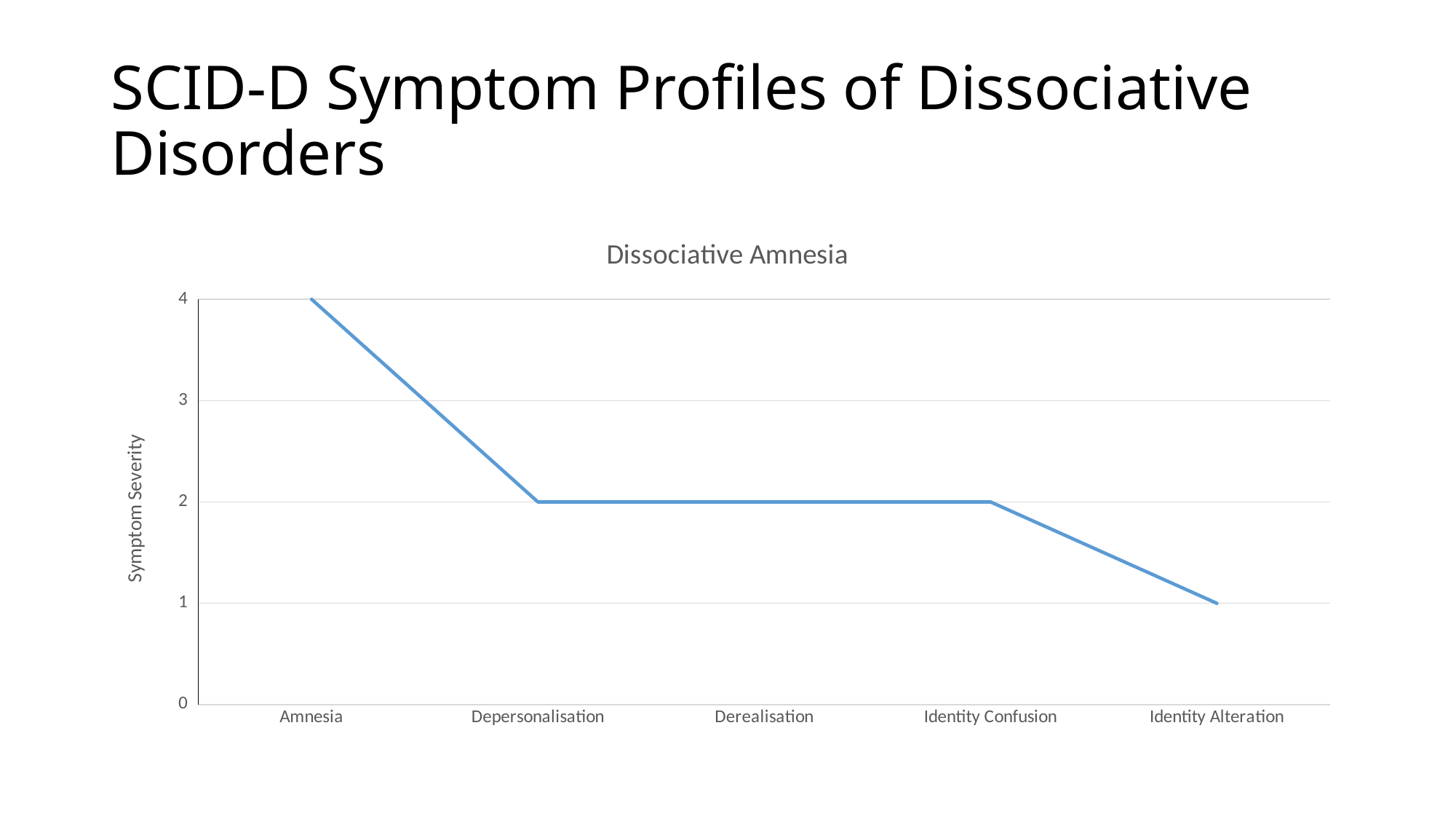
What is the label of the vertical axis? Symptom Severity What is the symptom severity value for Amnesia? 4 Which has a higher symptom severity, Identity Confusion or Identity Alteration? Identity Confusion Do the values generally rise or fall from left to right along the x axis? fall Which symptom has the highest severity? Amnesia What is the symptom severity value for Identity Alteration? 1 What is the symptom severity value for Derealisation? 2 How many symptom categories are plotted on the x axis? 5 What type of chart is shown on the slide? line chart Which symptom has the lowest severity? Identity Alteration What is the title of the chart? Dissociative Amnesia What is the difference in symptom severity between Amnesia and Depersonalisation? 2